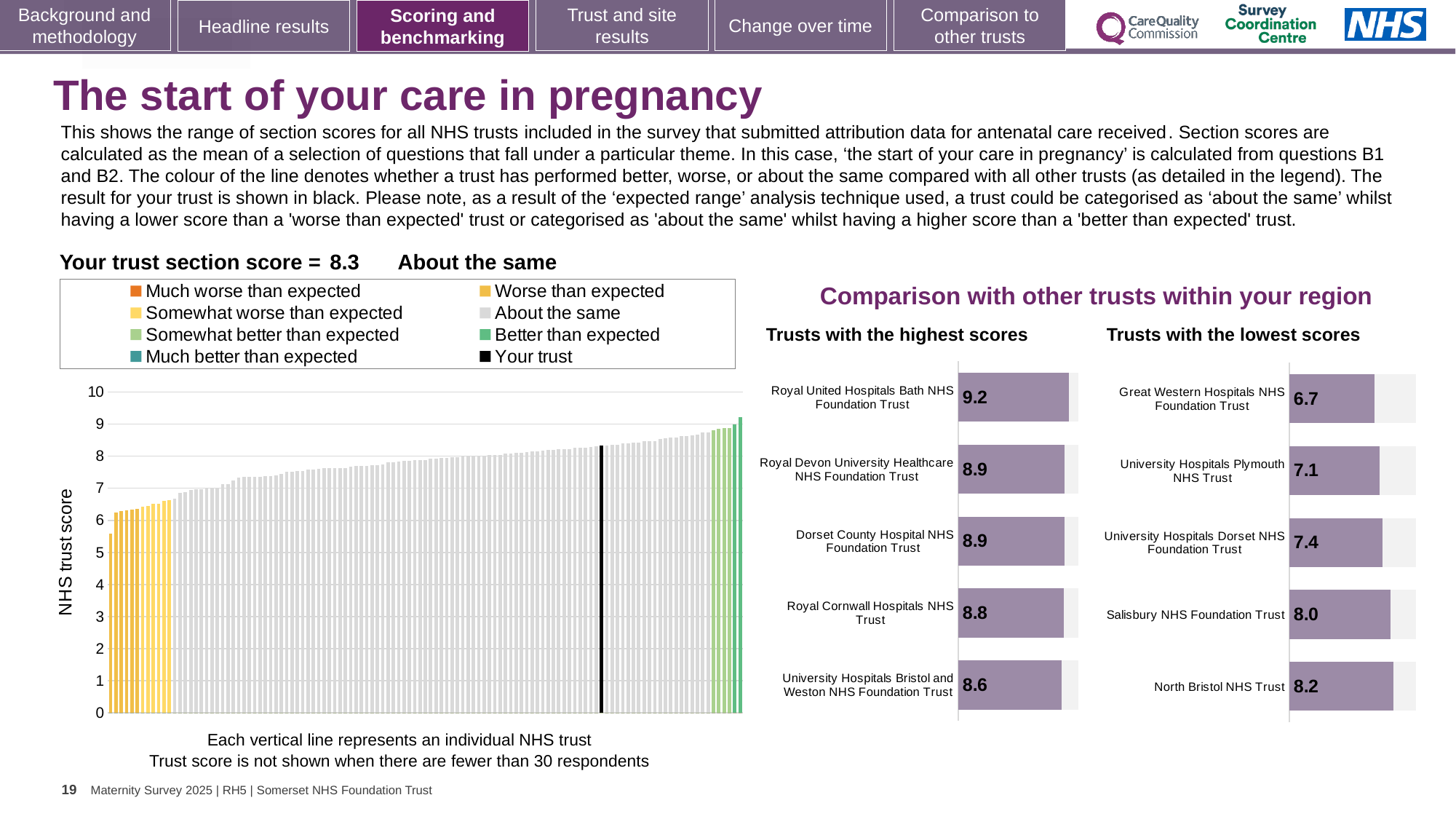
In the large chart on the left showing all NHS trusts, do the bar values rise or fall from left to right? rise In the 'Trusts with the highest scores' chart, what is the score for Royal United Hospitals Bath NHS Foundation Trust? 9.2 What type of chart is the large chart on the left showing all NHS trusts? bar chart In the 'Trusts with the lowest scores' chart, what is the score for Great Western Hospitals NHS Foundation Trust? 6.7 In the 'Trusts with the highest scores' chart, which trust has the highest score? Royal United Hospitals Bath NHS Foundation Trust How many trusts are shown in the 'Trusts with the highest scores' chart? 5 In the 'Trusts with the lowest scores' chart, which has the higher score: Salisbury NHS Foundation Trust or University Hospitals Plymouth NHS Trust? Salisbury NHS Foundation Trust In the 'Trusts with the highest scores' chart, what is the difference between the scores of Royal United Hospitals Bath NHS Foundation Trust and University Hospitals Bristol and Weston NHS Foundation Trust? 0.6 In the 'Trusts with the lowest scores' chart, what is the difference between the scores of North Bristol NHS Trust and Great Western Hospitals NHS Foundation Trust? 1.5 In the 'Trusts with the lowest scores' chart, which trust has the lowest score? Great Western Hospitals NHS Foundation Trust In the large chart on the left showing all NHS trusts, is the value for the black 'Your trust' bar greater or less than 8? greater In the 'Trusts with the lowest scores' chart, what is the score for Salisbury NHS Foundation Trust? 8.0